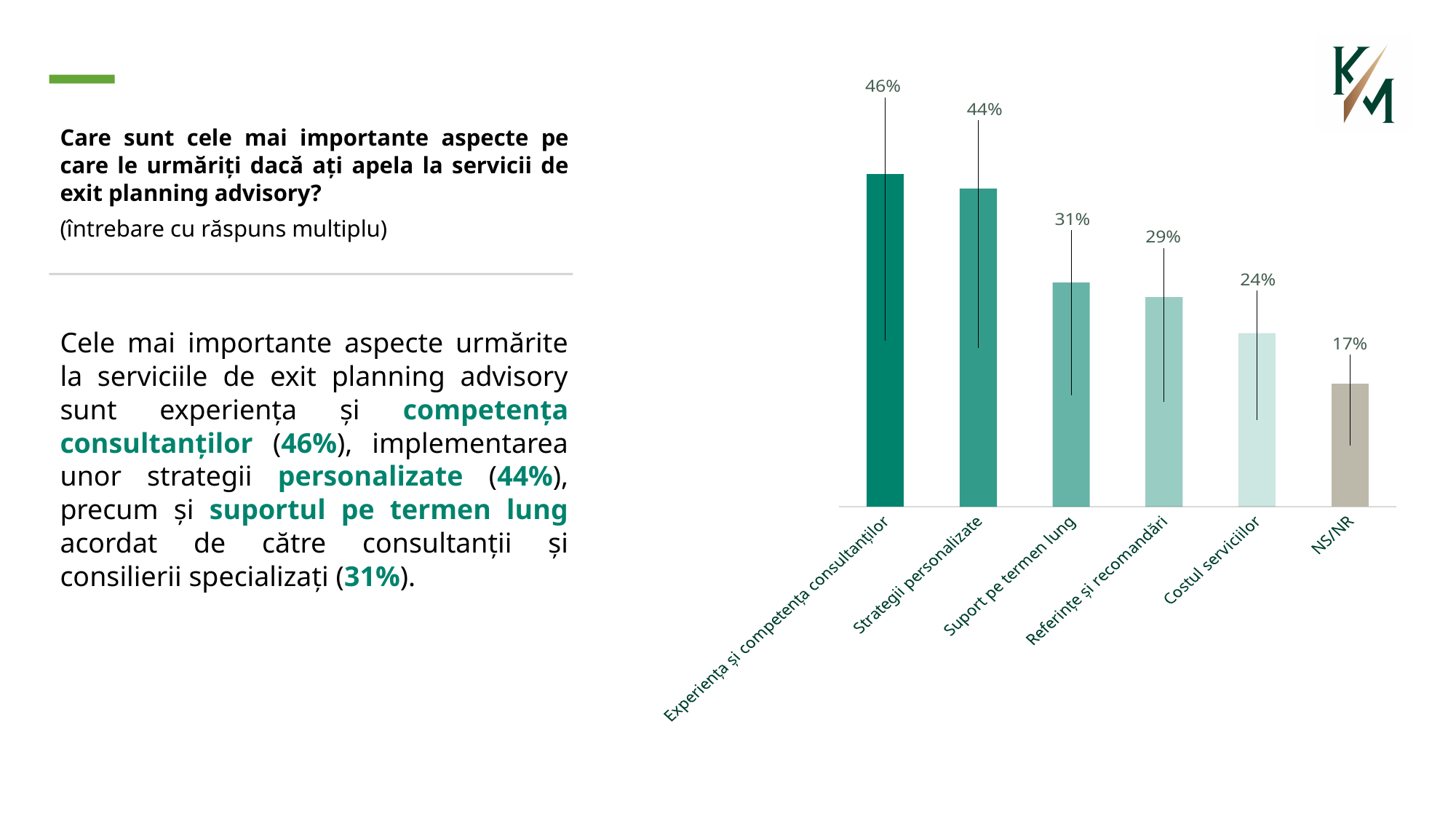
What is the value for "Referințe și recomandări"? 29% What is the value for "Strategii personalizate"? 44% What kind of chart is shown on the slide? Bar chart Which category has the highest value? Experiența și competența consultanților What is the value for "Experiența și competența consultanților"? 46% Which category has the lowest value? NS/NR How many categories are shown in the chart? 6 Which is larger, the value for "Costul serviciilor" or the value for "Referințe și recomandări"? Referințe și recomandări What is the value for "Costul serviciilor"? 24% What is the difference between the values for "Experiența și competența consultanților" and "Suport pe termen lung"? 15% What is the value for "NS/NR"? 17% What is the value for "Suport pe termen lung"? 31%